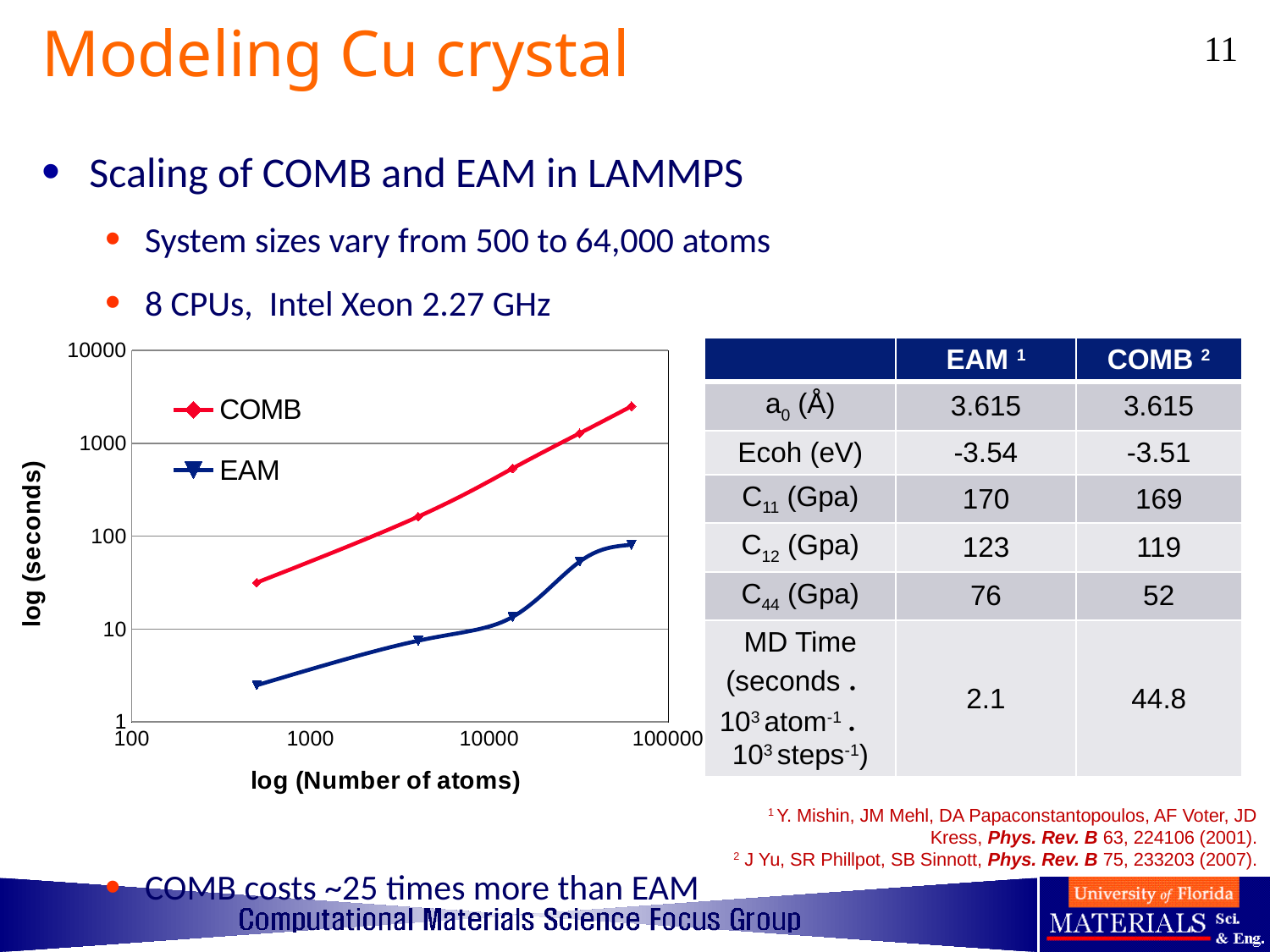
How many series does the chart legend list? 2 Which two series are listed in the chart legend? COMB and EAM Do the values for the COMB series rise or fall as the number of atoms increases? rise Is the value for EAM at the smallest system size greater or less than 10 seconds? less Is the value for EAM at the largest system size greater or less than 100 seconds? less Do the values for the EAM series rise or fall as the number of atoms increases? rise What kind of chart is shown on the slide? line chart Is the value for COMB at the smallest system size greater or less than 10 seconds? greater What is the title of the chart's y axis? log (seconds) How many data points are plotted for the COMB series? 5 Which series has the higher values across the chart, COMB or EAM? COMB